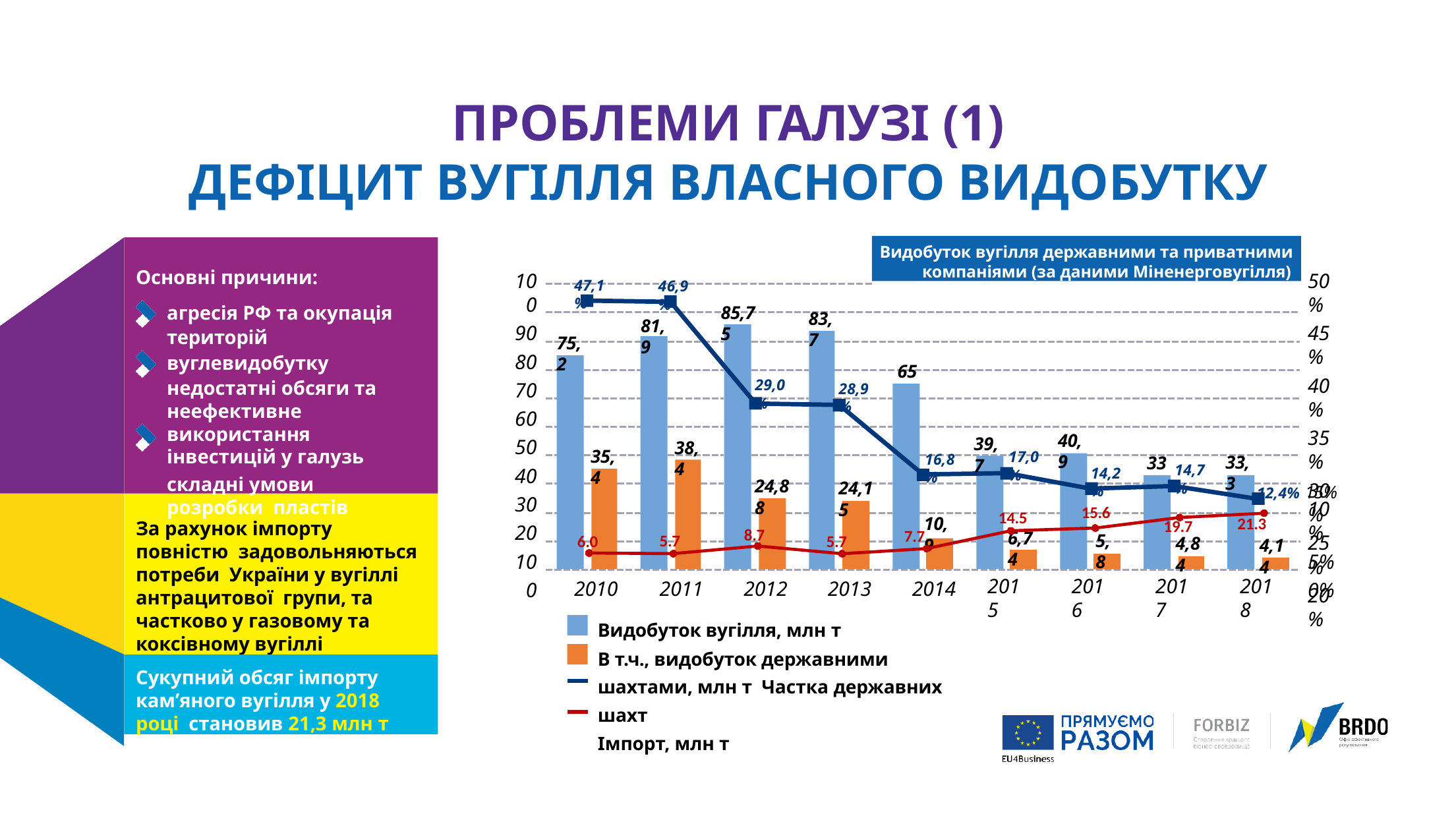
In which year is Видобуток вугілля, млн т the highest? 2012 What is the difference between Видобуток вугілля, млн т in 2011 and in 2010? 6,7 Does Частка державних шахт rise or fall from 2010 to 2018? Fall What kind of chart is shown on the slide? Combined bar and line chart How many series does the chart legend list? 4 What is the value of Імпорт, млн т for 2018? 21.3 Which year has the larger value of Імпорт, млн т: 2014 or 2015? 2015 What is the value of Частка державних шахт for 2010? 47,1% How many years are shown on the x axis of the chart? 9 What is the value of В т.ч., видобуток державними шахтами, млн т for 2011? 38,4 In which year is Частка державних шахт the lowest? 2018 What is the value of Видобуток вугілля, млн т for 2012? 85,75